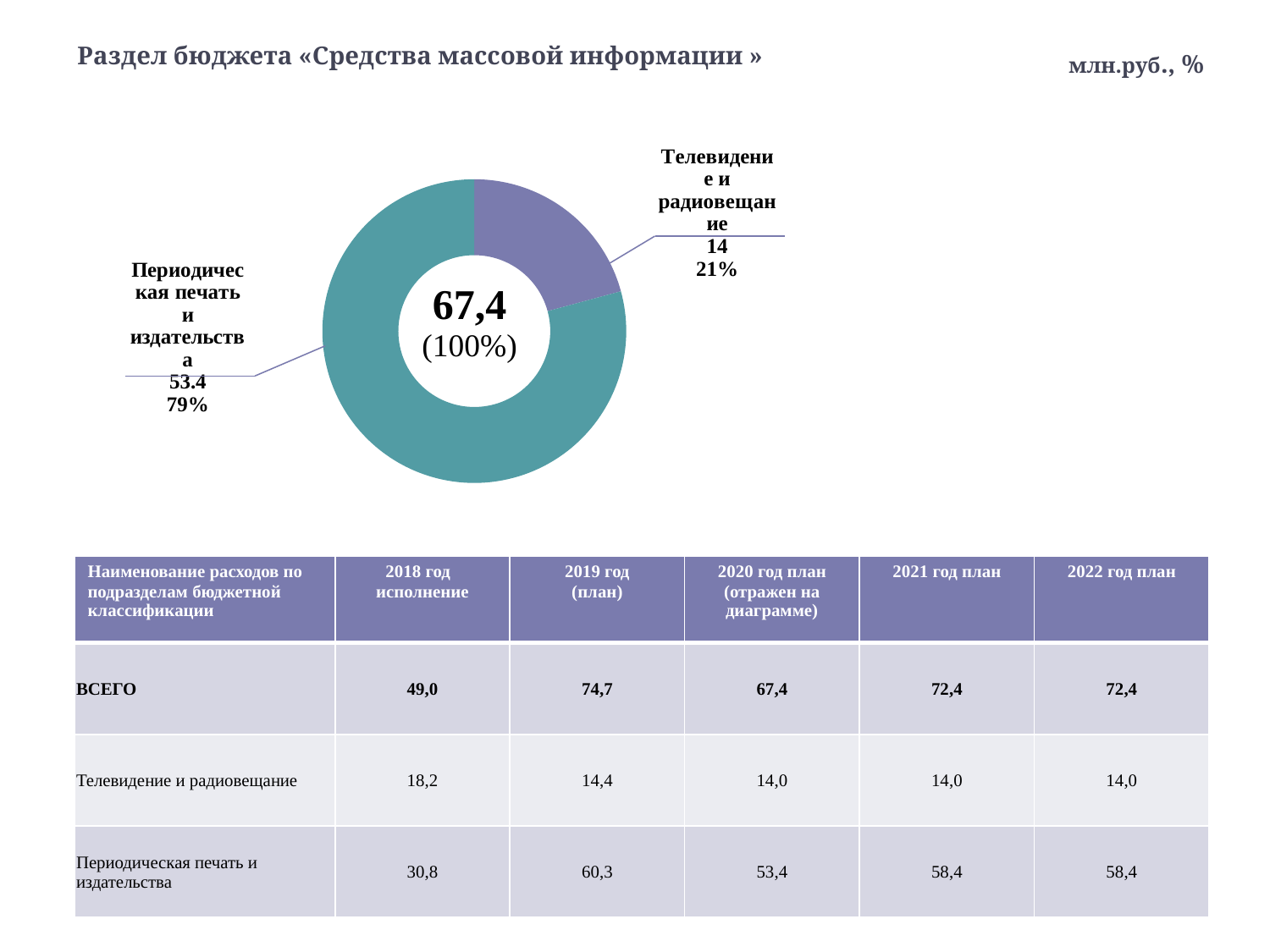
What is the title of the slide containing the donut chart? Раздел бюджета «Средства массовой информации » Which slice of the donut chart is the smallest? Телевидение и радиовещание What type of chart is shown on the slide? Donut (pie) chart Which is larger in the donut chart: «Телевидение и радиовещание» or «Периодическая печать и издательства»? Периодическая печать и издательства What share of the donut chart does «Телевидение и радиовещание» represent? 21% What total value is shown in the centre of the donut chart? 67,4 What is the difference between the values of «Периодическая печать и издательства» (53.4) and «Телевидение и радиовещание» (14) in the donut chart? 39.4 Which slice of the donut chart is the largest? Периодическая печать и издательства How many slices does the donut chart have? 2 What value is shown for the slice «Периодическая печать и издательства» in the donut chart? 53.4 What share of the donut chart does «Периодическая печать и издательства» represent? 79% What value is shown for the slice «Телевидение и радиовещание» in the donut chart? 14